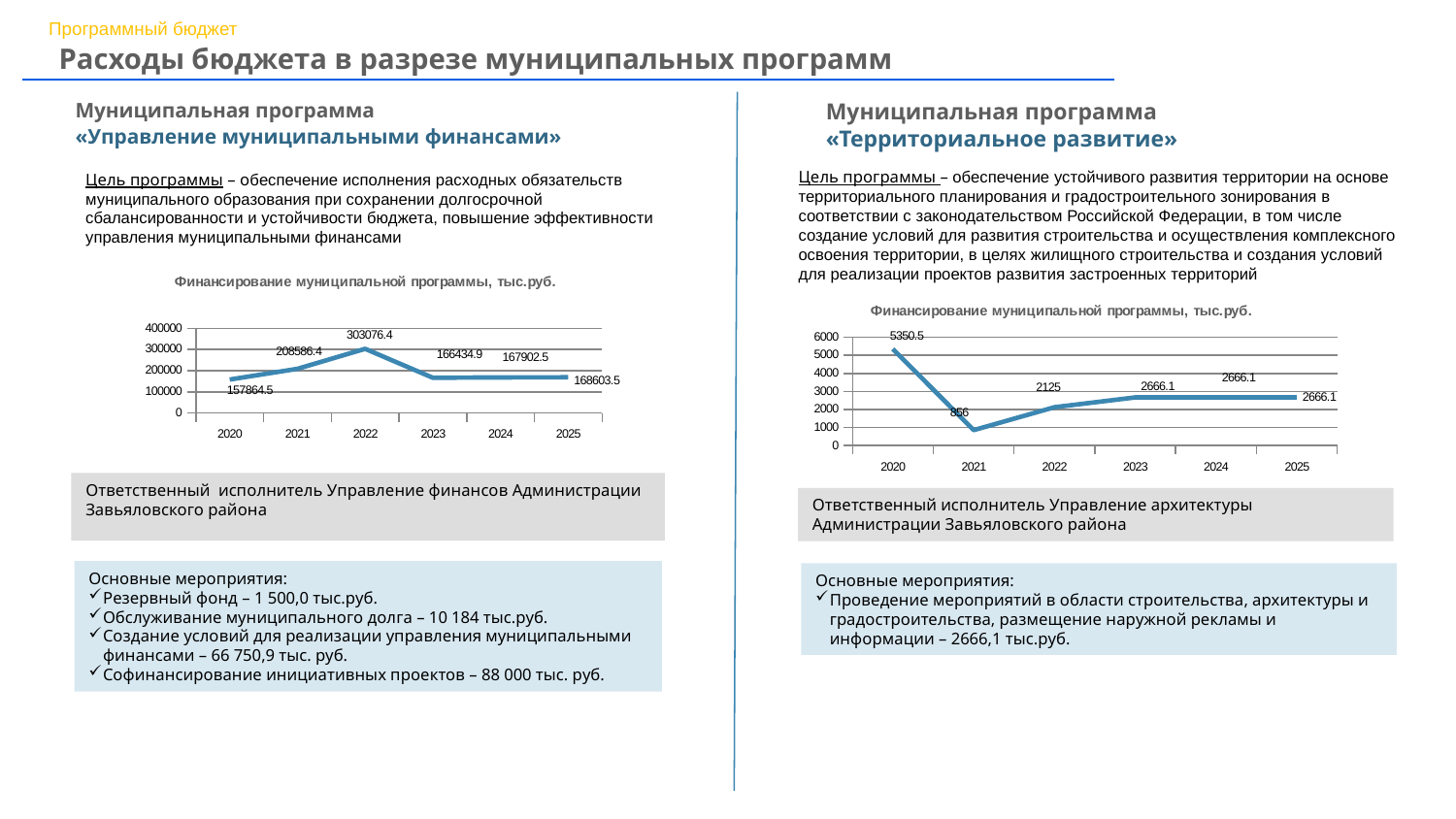
In the right chart, which is larger, the value for 2022 or the value for 2023? 2023 What type of chart is shown on the left side of the slide? line chart In the left chart, which year has the lowest value? 2020 In the right chart, what is the value for 2020? 5350.5 In the left chart, what is the value for 2020? 157864.5 In the right chart, which year has the lowest value? 2021 In the left chart, which year has the highest value? 2022 In the right chart, what is the difference between the values for 2020 and 2021? 4494.5 In the right chart, what is the value for 2021? 856 In the left chart, what is the difference between the values for 2022 and 2021? 94490 In the left chart, what is the value for 2022? 303076.4 In the left chart, how many years are plotted? 6